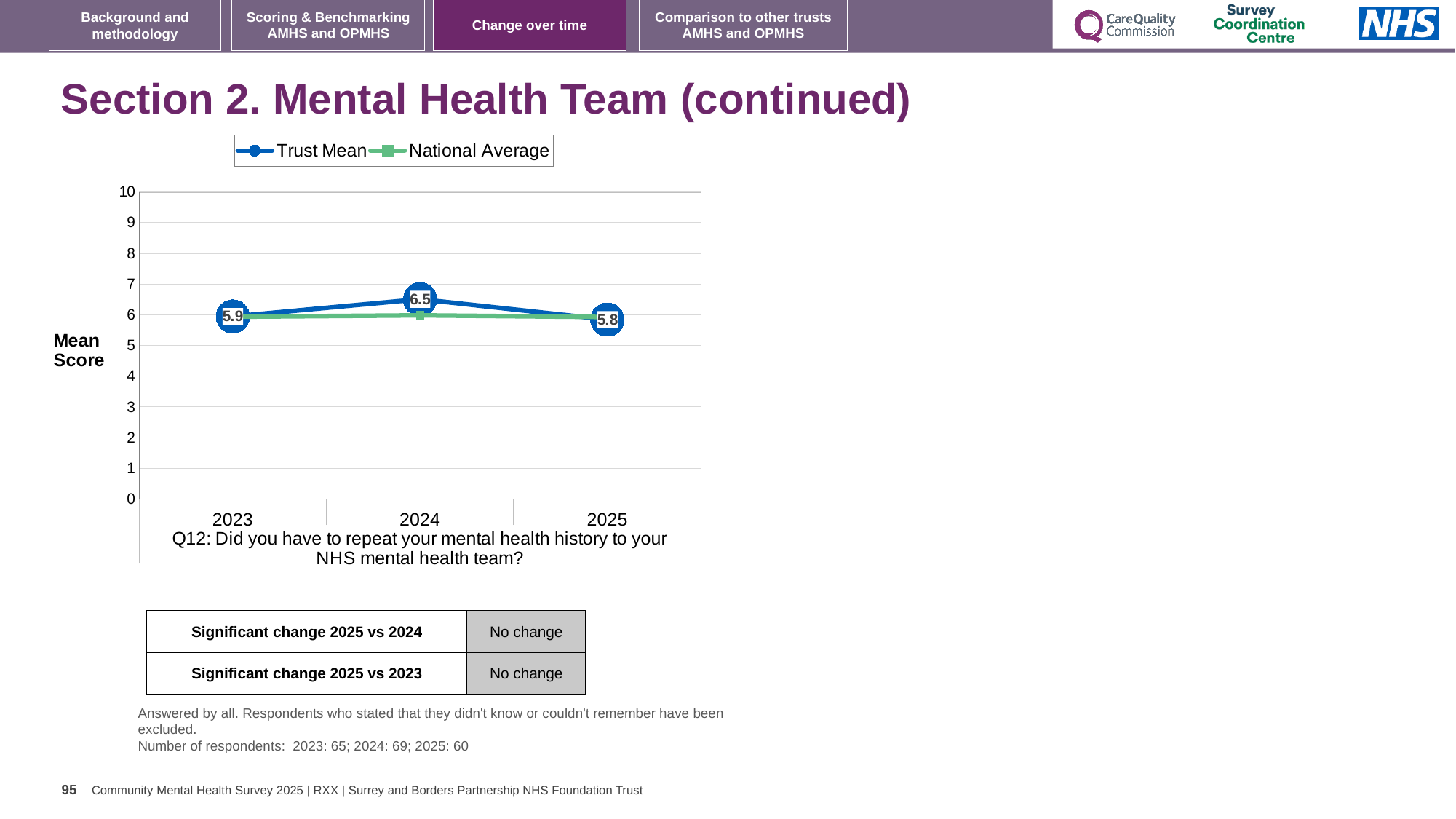
What is the difference between the Trust Mean in 2024 and in 2023? 0.6 What is the difference between the Trust Mean in 2024 and in 2025? 0.7 How many years are plotted on the x axis? 3 What is the Trust Mean value for 2025? 5.8 How many series does the legend list? 2 In which year is the Trust Mean lowest? 2025 What is the Trust Mean value for 2023? 5.9 In which year is the Trust Mean highest? 2024 What kind of chart is shown on the slide? Line chart Which year has the larger Trust Mean, 2023 or 2025? 2023 Is the National Average value for 2024 greater or less than 7? less What is the Trust Mean value for 2024? 6.5